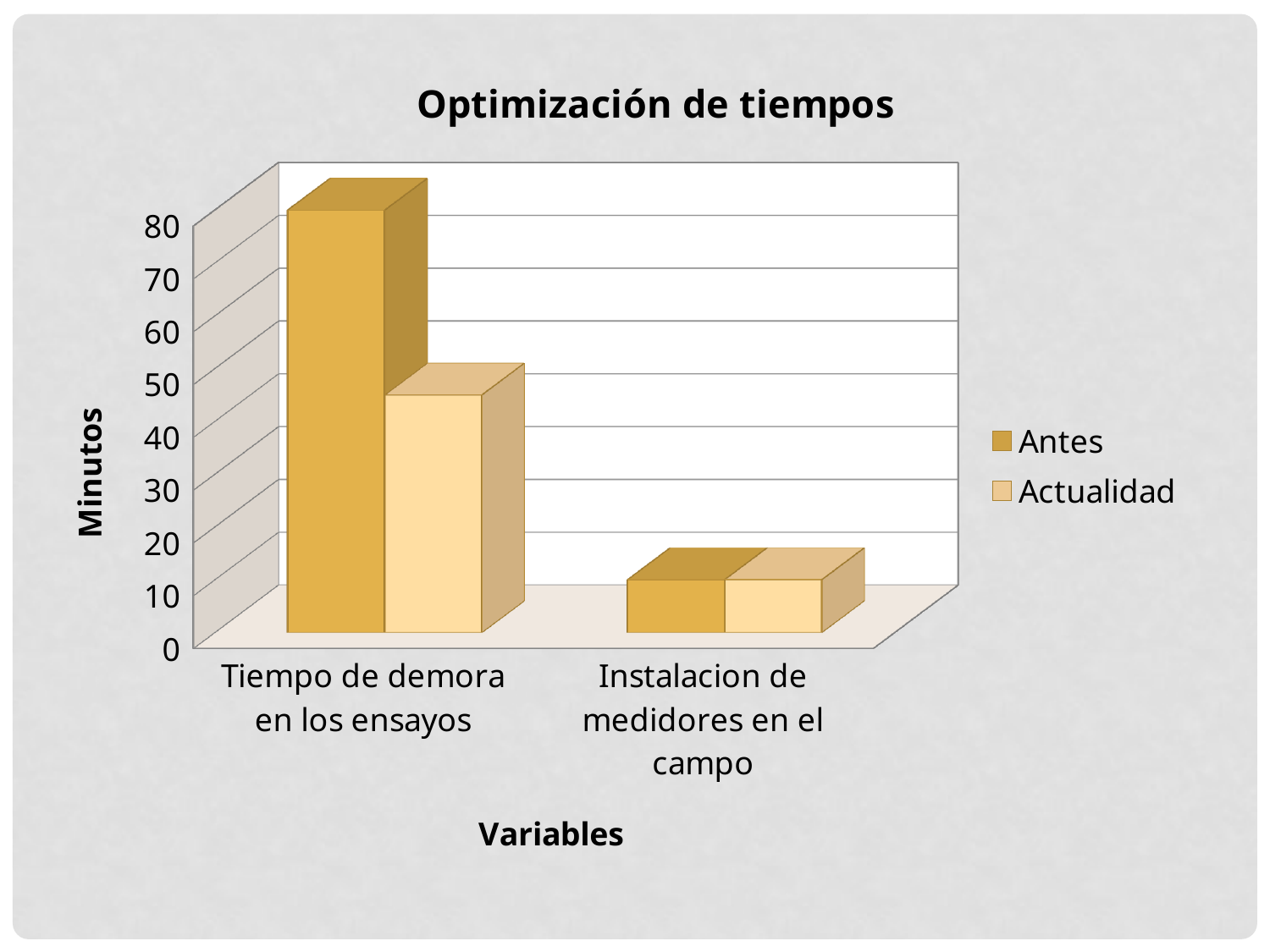
Is the Antes value for Instalacion de medidores en el campo greater or less than 20? less How many series does the legend list? 2 What is the label of the vertical axis? Minutos Is the Antes value for Tiempo de demora en los ensayos greater or less than 70? greater Which category has the lowest values overall? Instalacion de medidores en el campo How many categories are shown on the x axis? 2 For Tiempo de demora en los ensayos, which series has the larger value, Antes or Actualidad? Antes Which bar is the tallest in the chart? Antes for Tiempo de demora en los ensayos Is the Actualidad value for Tiempo de demora en los ensayos greater or less than 30? greater What is the title of the chart? Optimización de tiempos What kind of chart is shown on the slide? bar chart